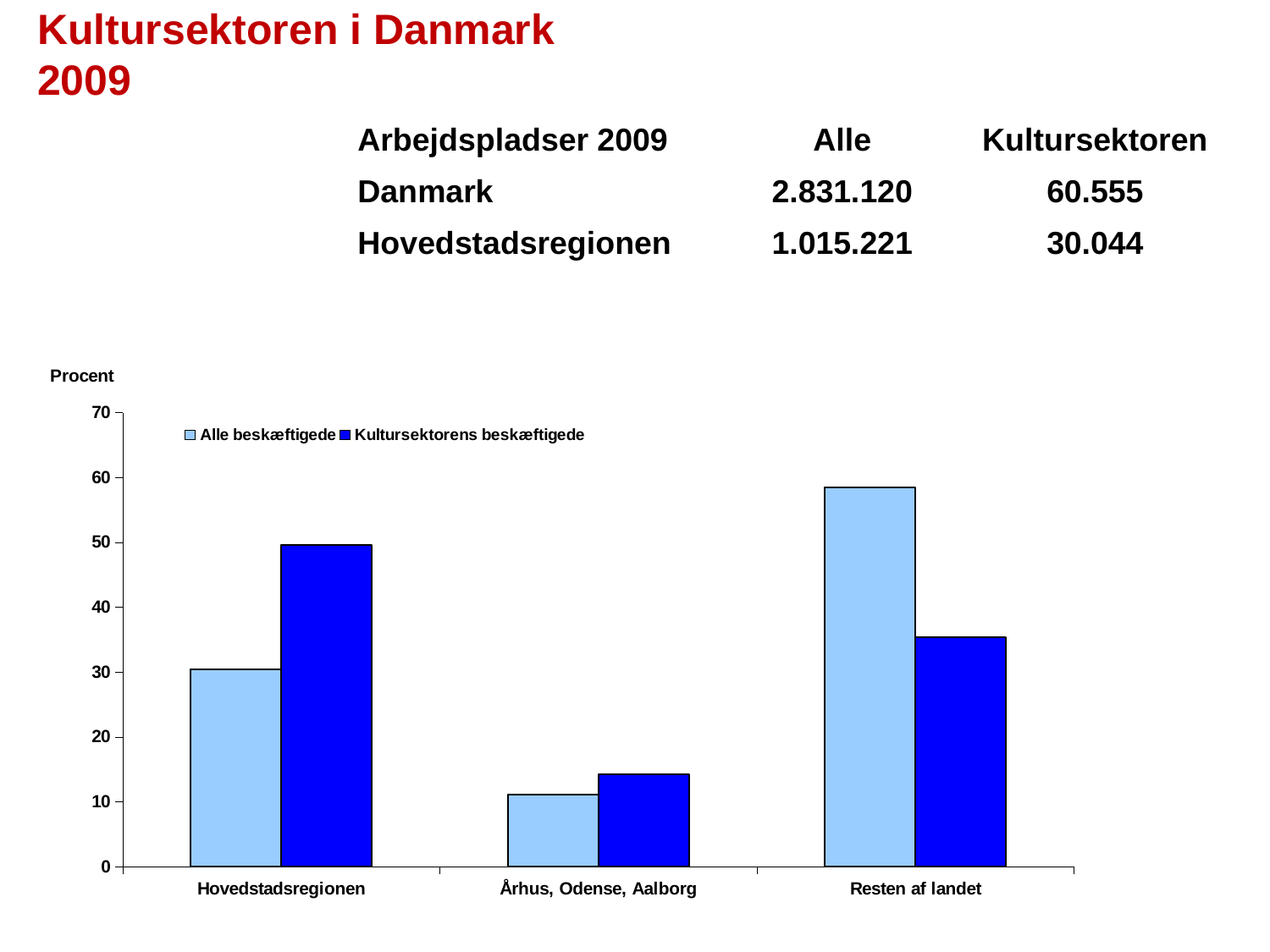
In Resten af landet, which is larger: Alle beskæftigede or Kultursektorens beskæftigede? Alle beskæftigede Is the value for Alle beskæftigede in Århus, Odense, Aalborg greater or less than 20? less Is the value for Kultursektorens beskæftigede in Hovedstadsregionen greater or less than 40? greater How many series does the chart legend list? 2 Which category has the lowest value for Kultursektorens beskæftigede? Århus, Odense, Aalborg Which category has the highest value for Alle beskæftigede? Resten af landet What kind of chart is shown on the slide? bar chart How many categories are shown on the x axis of the chart? 3 In Hovedstadsregionen, which is larger: Alle beskæftigede or Kultursektorens beskæftigede? Kultursektorens beskæftigede Which category has the highest value for Kultursektorens beskæftigede? Hovedstadsregionen Is the value for Alle beskæftigede in Resten af landet greater or less than 50? greater What label is shown on the vertical axis of the chart? Procent